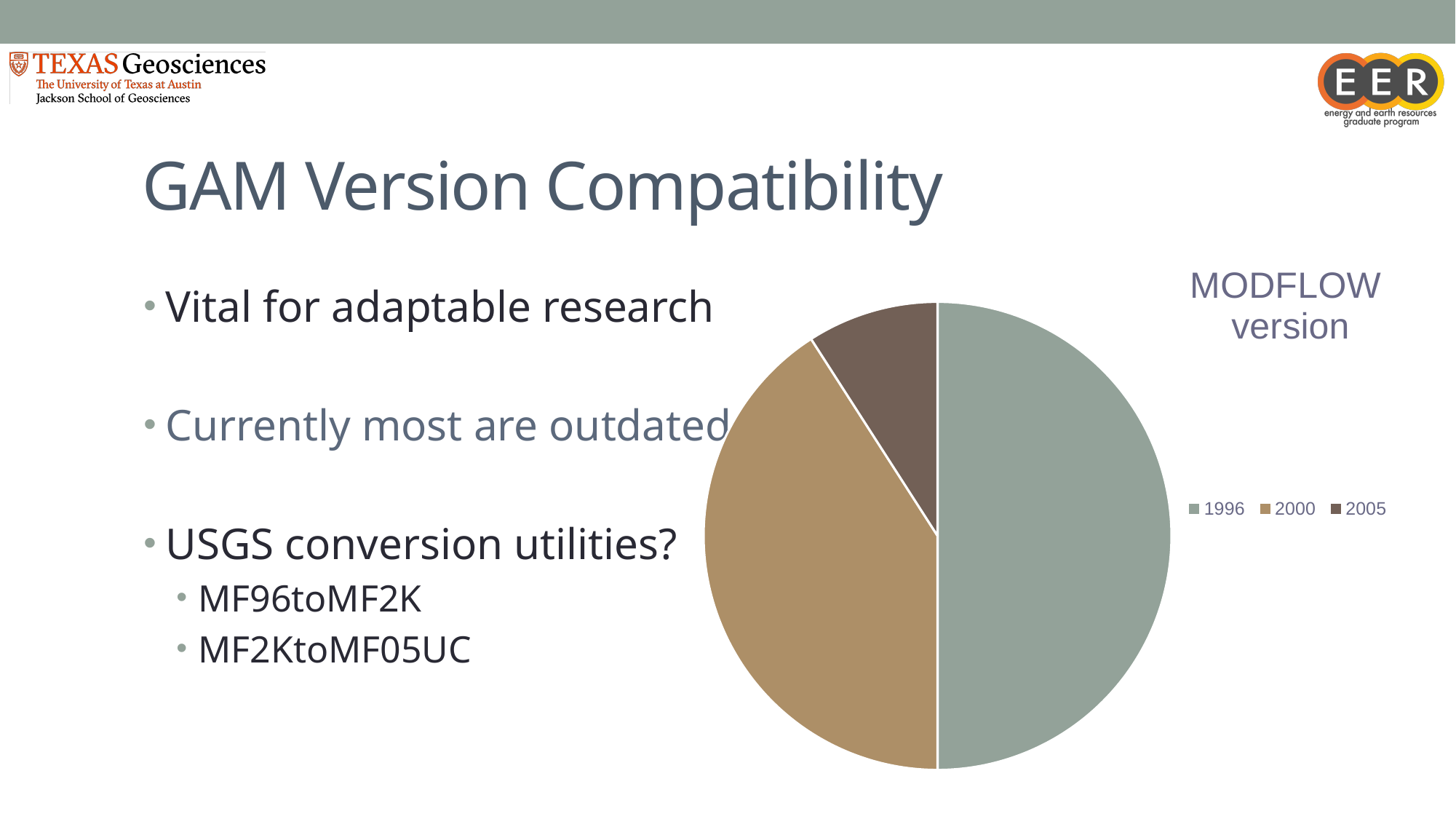
How many slices does the pie chart have? 3 What are the legend entries of the pie chart, in order? 1996, 2000, 2005 Which MODFLOW version has the largest slice in the pie chart? 1996 Which MODFLOW version has the smallest slice in the pie chart? 2005 Which slice is larger in the pie chart, 1996 or 2000? 1996 Which slice is larger in the pie chart, 1996 or 2005? 1996 Which slice is larger in the pie chart, 2000 or 2005? 2000 How many entries does the legend of the pie chart list? 3 What is the title of the pie chart? MODFLOW version What kind of chart is shown on the slide? pie chart